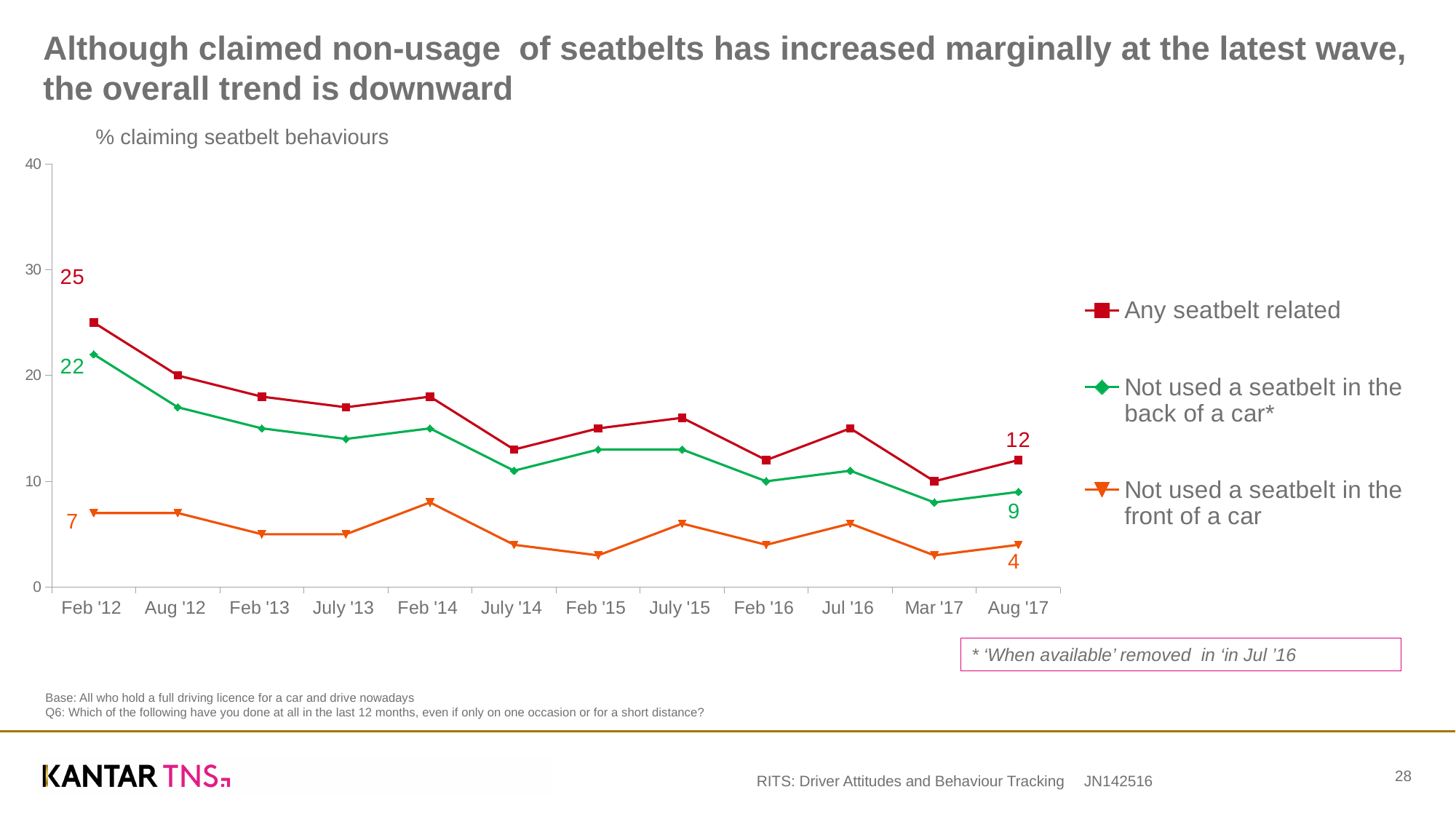
By how much did the value for Any seatbelt related fall between Feb '12 and Aug '17? 13 What is the value for Any seatbelt related at Aug '17? 12 What is the difference between Not used a seatbelt in the front of a car at Feb '12 and at Aug '17? 3 Which series has the lowest value at Aug '17? Not used a seatbelt in the front of a car Is the value for Any seatbelt related at Feb '14 greater or less than 10? greater What kind of chart is shown on the slide? line chart At Feb '12, which is larger: Not used a seatbelt in the back of a car or Not used a seatbelt in the front of a car? Not used a seatbelt in the back of a car How many time points are shown on the x axis? 12 What is the value for Not used a seatbelt in the back of a car at Aug '17? 9 How many series does the legend list? 3 What is the value for Not used a seatbelt in the front of a car at Feb '12? 7 What is the value for Any seatbelt related at Feb '12? 25